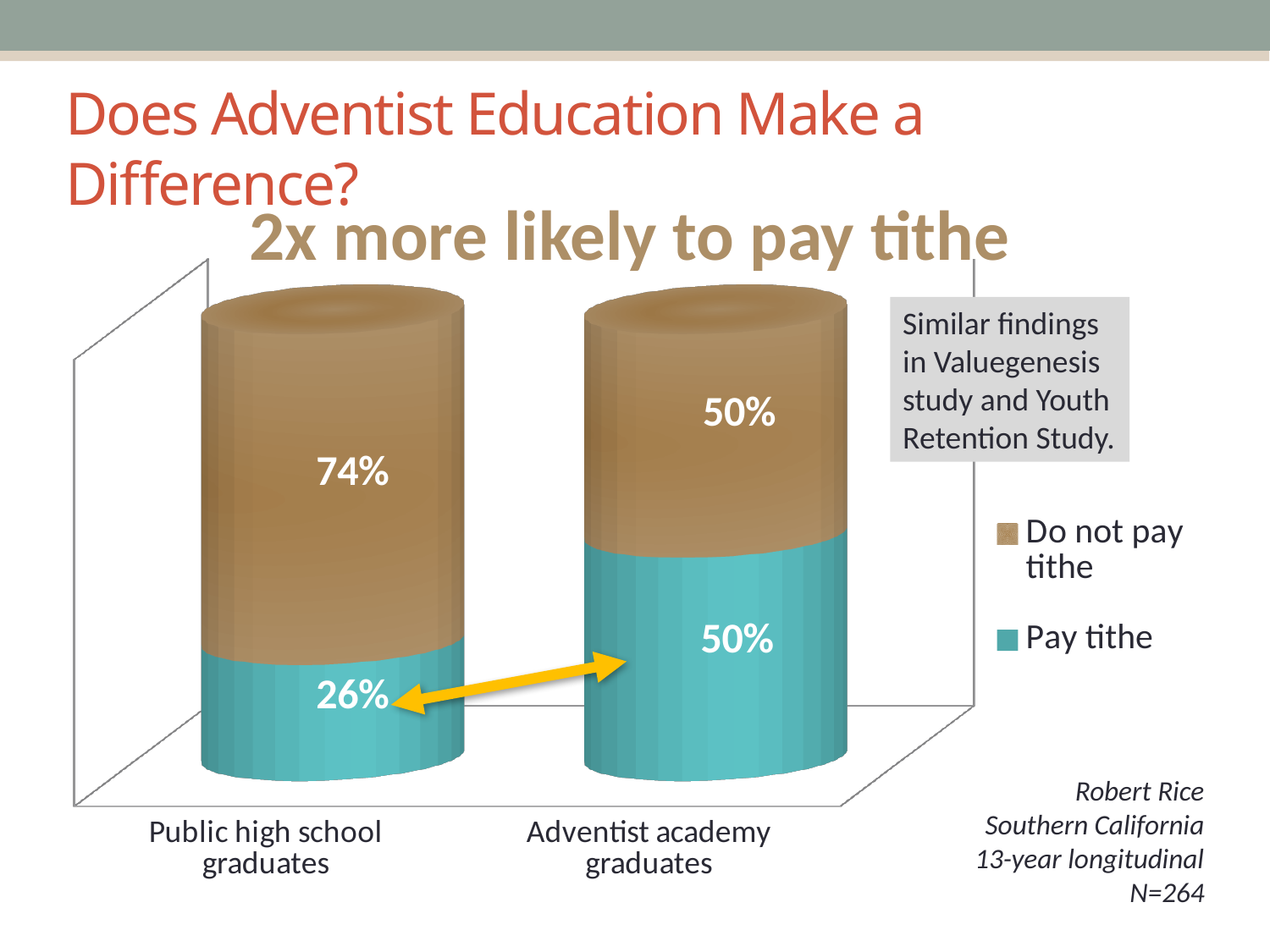
How many categories are shown on the x axis? 2 What kind of chart is shown? Stacked bar chart What percentage of public high school graduates pay tithe? 26% What is the difference between the 'Pay tithe' share for Adventist academy graduates and for public high school graduates? 24% What percentage of Adventist academy graduates pay tithe? 50% What percentage of Adventist academy graduates do not pay tithe? 50% Is the 'Do not pay tithe' share larger for public high school graduates or Adventist academy graduates? Public high school graduates Which group has the higher share paying tithe? Adventist academy graduates How many series does the legend list? 2 What percentage of public high school graduates do not pay tithe? 74% What is the title of the chart? 2x more likely to pay tithe Which group has the lower share paying tithe? Public high school graduates